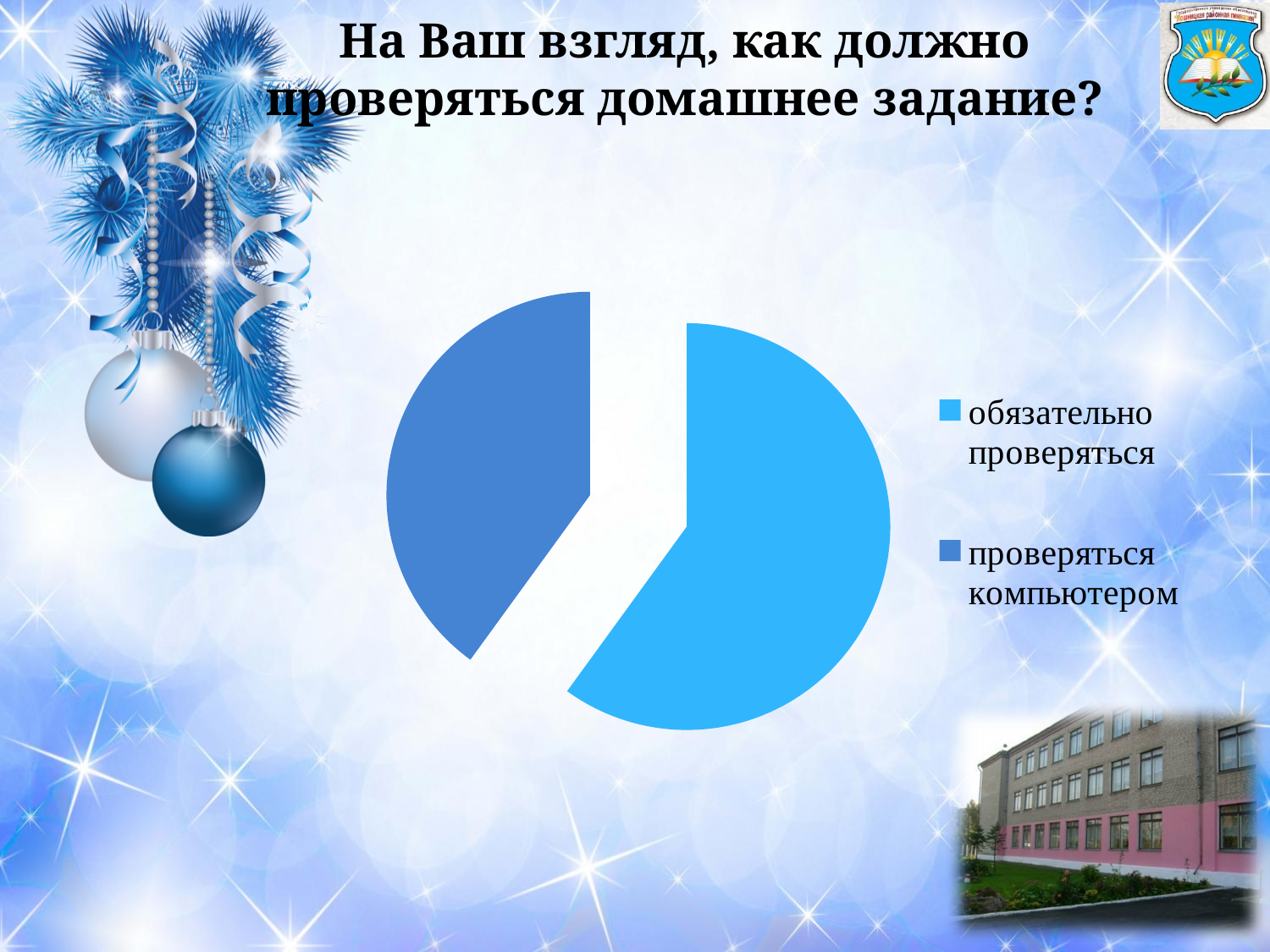
Which legend entry is shown in the lighter blue colour? обязательно проверяться Does the slice for "проверяться компьютером" take up more or less than half of the pie? less Which category has the largest slice in the pie chart? обязательно проверяться Which slice is larger: "обязательно проверяться" or "проверяться компьютером"? обязательно проверяться Which category has the smallest slice in the pie chart? проверяться компьютером What kind of chart is shown on the slide? pie chart How many slices does the pie chart have? 2 What is the title of the slide containing the pie chart? На Ваш взгляд, как должно проверяться домашнее задание? How many entries does the legend of the pie chart list? 2